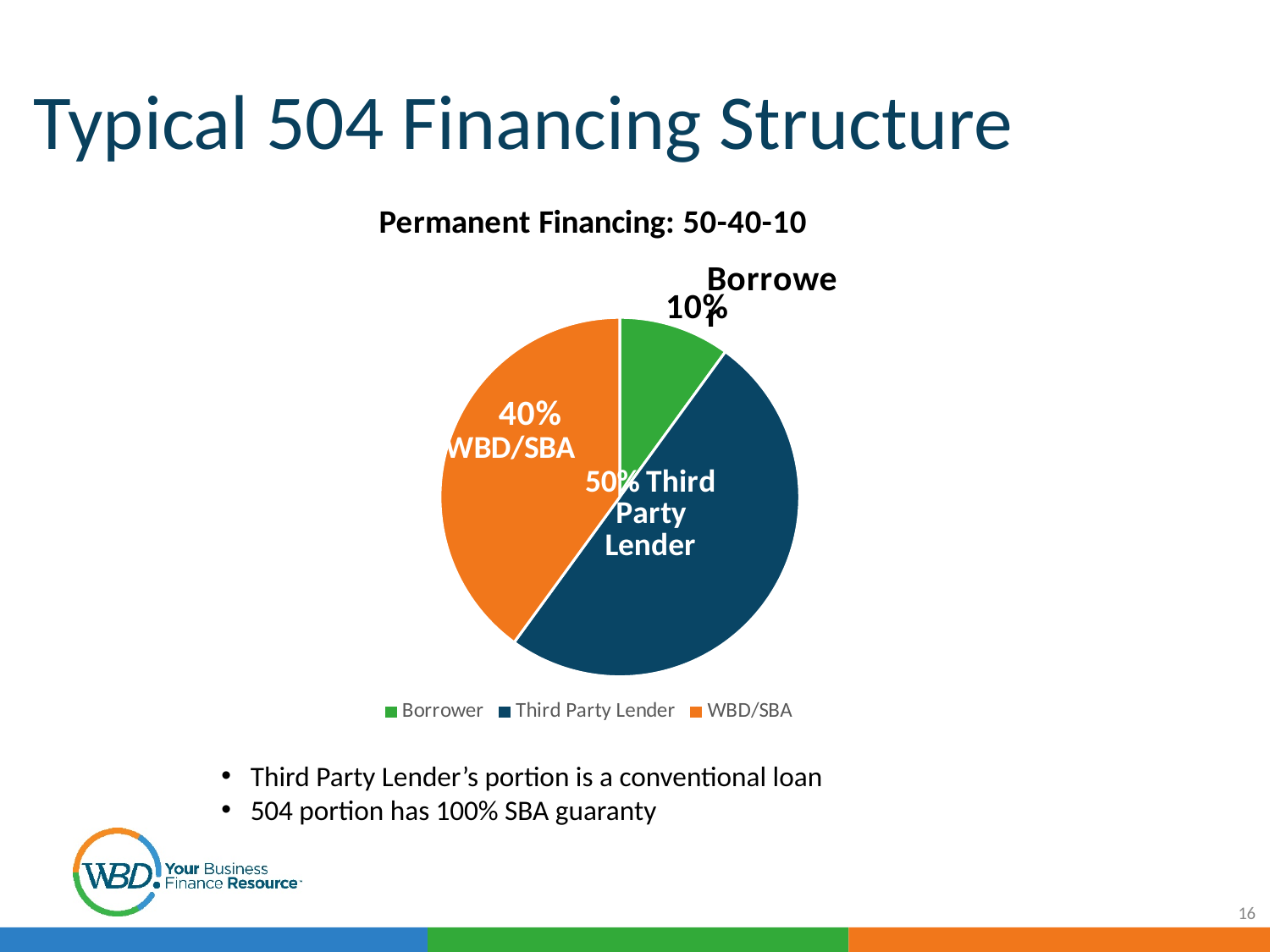
What type of chart is shown on the slide? pie chart What share of the pie does the Borrower slice represent? 10% What is the difference in percentage points between the Third Party Lender slice and the WBD/SBA slice? 10% What share of the pie does the Third Party Lender slice represent? 50% How many slices does the pie chart have? 3 Which slice is larger, WBD/SBA or Borrower? WBD/SBA What colour is the WBD/SBA slice? orange Which category has the smallest slice of the pie? Borrower What is the title of the chart? Permanent Financing: 50-40-10 Which category has the largest slice of the pie? Third Party Lender How many entries does the legend list? 3 What share of the pie does the WBD/SBA slice represent? 40%